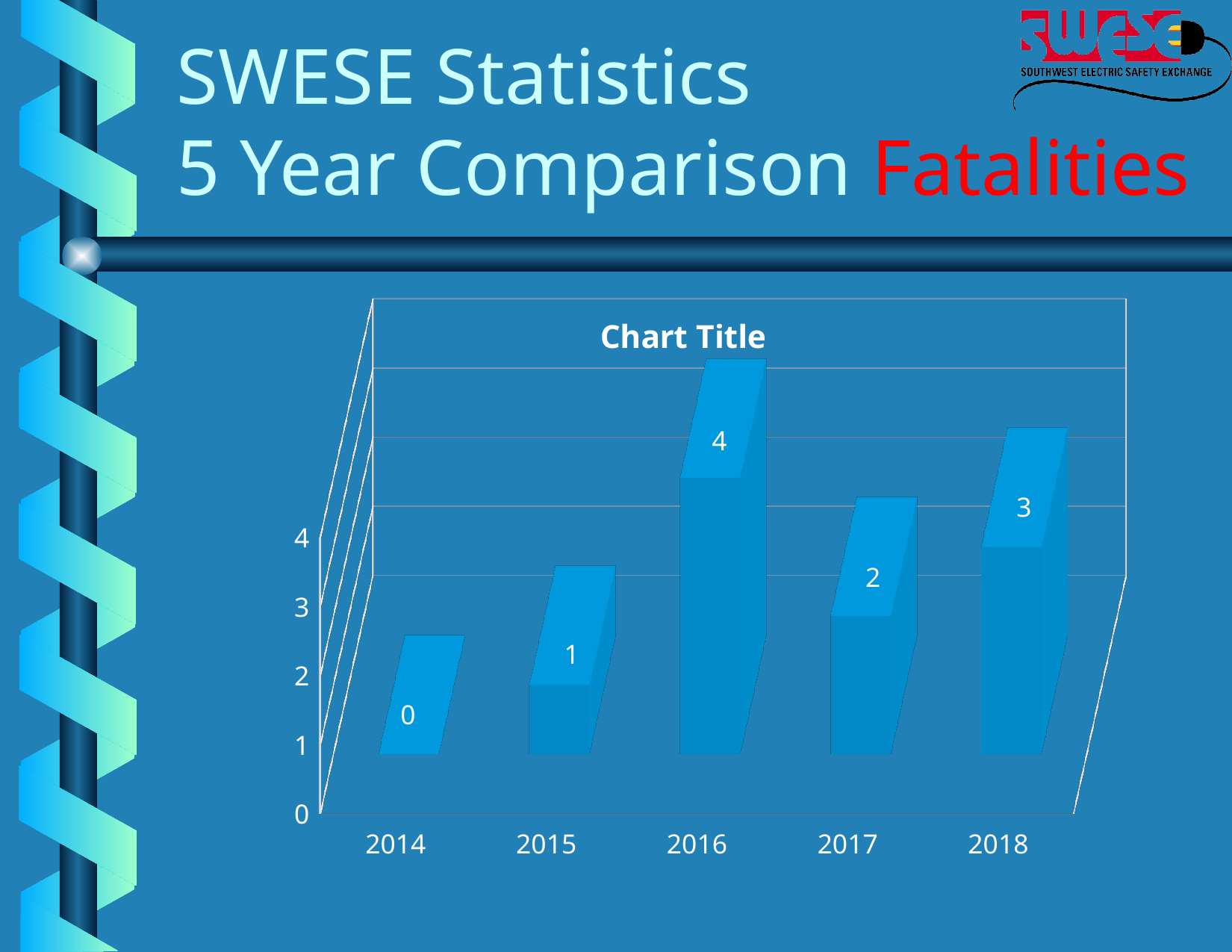
What is the value for 2018? 3 What is the difference between the values for 2016 and 2015? 3 Which is larger, the value for 2017 or the value for 2018? 2018 What is the value for 2014? 0 What kind of chart is shown on the slide? bar chart Do the values rise or fall from 2014 to 2016? rise What is the value for 2017? 2 What is the title printed above the chart? Chart Title Which year has the lowest value? 2014 How many years are shown on the x axis? 5 Which year has the highest value? 2016 What is the value for 2016? 4